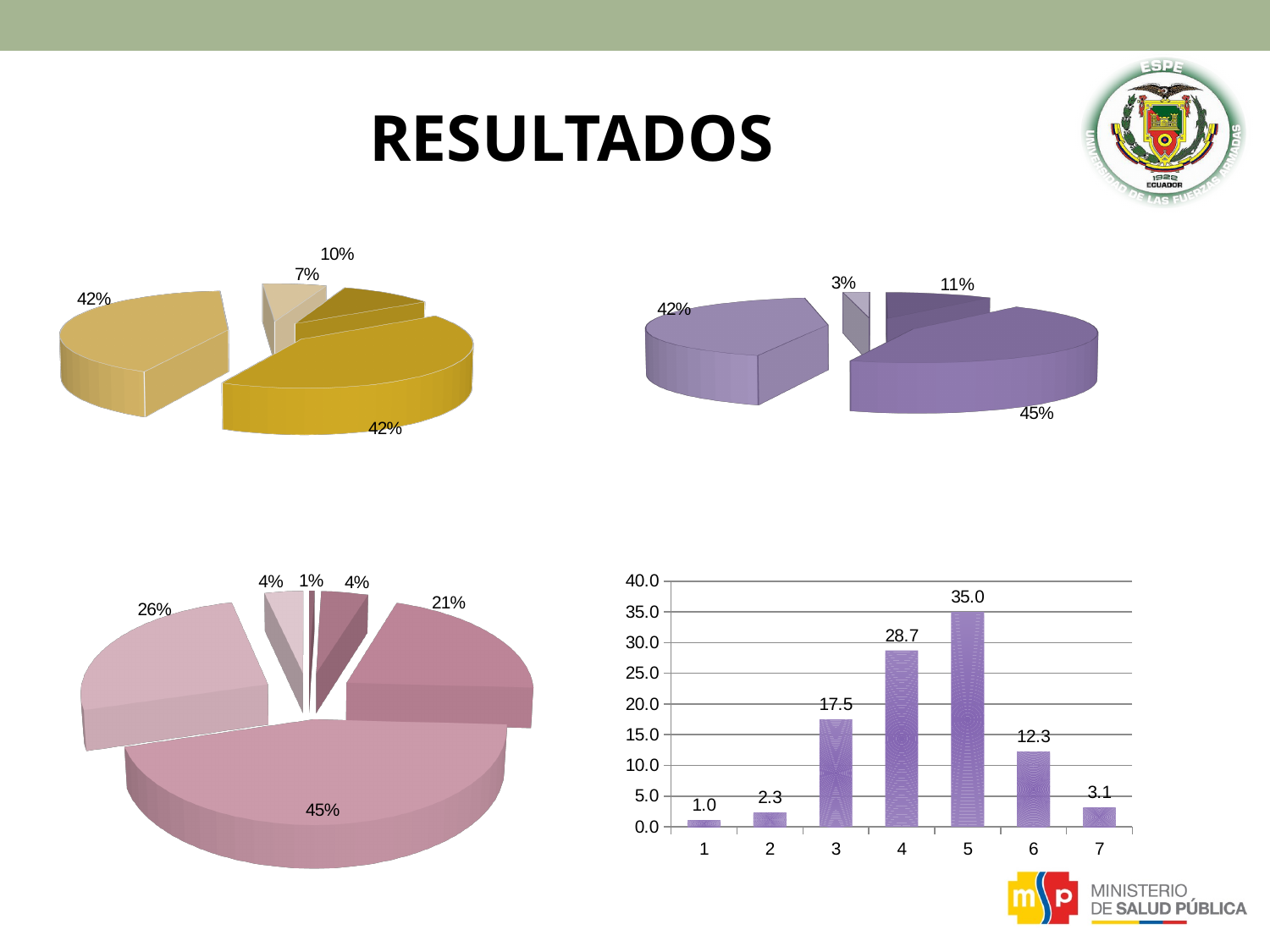
On the bar chart at the bottom right, what is the value for category 3? 17.5 What kind of chart is shown at the bottom right of the slide? Bar chart On the bar chart at the bottom right, which category has the lowest value? 1 On the pie chart at the bottom left, what is the share of the largest slice? 45% On the bar chart at the bottom right, what is the value for category 5? 35.0 On the bar chart at the bottom right, how many categories are shown on the x axis? 7 On the pie chart at the bottom left, how many slices does the pie have? 6 On the bar chart at the bottom right, which is larger, the value for category 6 or the value for category 7? Category 6 On the bar chart at the bottom right, which category has the highest value? 5 On the pie chart at the top right, what is the share of the smallest slice? 3% On the bar chart at the bottom right, what is the difference between the values for category 5 and category 4? 6.3 On the pie chart at the top left, how many slices does the pie have? 4